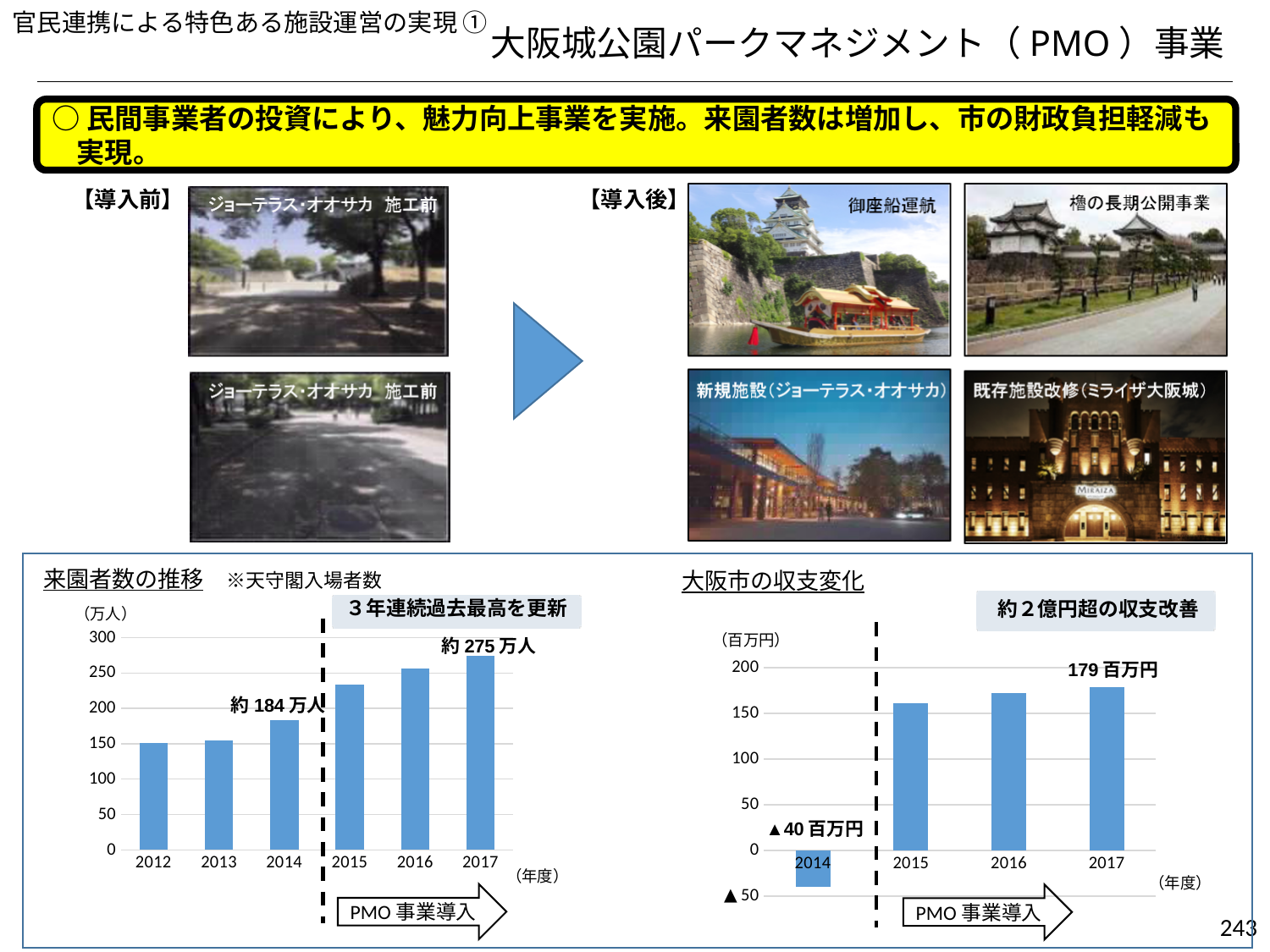
In the 大阪市の収支変化 chart, what is the value for 2014? ▲40百万円 In the 来園者数の推移 chart, which year has the highest value? 2017 What kind of chart is the 来園者数の推移 chart? Bar chart In the 来園者数の推移 chart, is the value for 2012 greater or less than 200? less In the 大阪市の収支変化 chart, what is the difference between the 2017 value and the 2014 value? 219百万円 In the 来園者数の推移 chart, what is the value for 2014? 約184万人 In the 大阪市の収支変化 chart, what is the value for 2017? 179百万円 In the 大阪市の収支変化 chart, which year has the lowest value? 2014 In the 来園者数の推移 chart, what is the value for 2017? 約275万人 In the 大阪市の収支変化 chart, how many years are plotted? 4 In the 大阪市の収支変化 chart, do the values rise or fall from 2014 to 2017? Rise In the 来園者数の推移 chart, how many years are plotted? 6